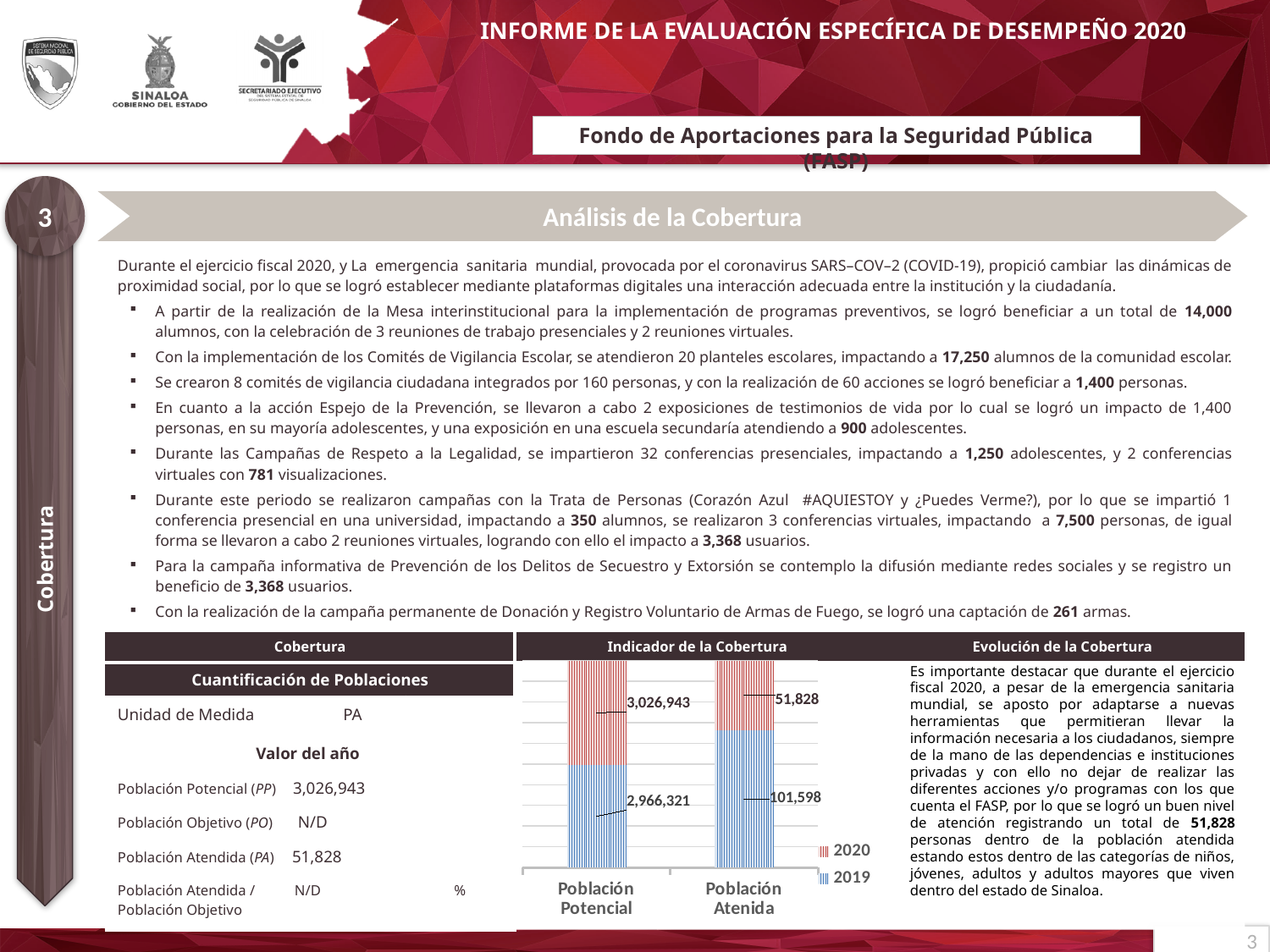
In the chart titled 'Indicador de la Cobertura', what is the difference between the 2019 and 2020 values for Población Atendida? 49,770 In the chart titled 'Indicador de la Cobertura', how many series does the legend list? 2 In the chart titled 'Indicador de la Cobertura', which category and year has the lowest labelled value? Población Atendida, 2020 In the chart titled 'Indicador de la Cobertura', what is the 2019 value for Población Atendida? 101,598 In the chart titled 'Indicador de la Cobertura', what is the difference between the 2020 and 2019 values for Población Potencial? 60,622 What kind of chart is the 'Indicador de la Cobertura' chart? Stacked bar chart In the chart titled 'Indicador de la Cobertura', what is the 2020 value for Población Potencial? 3,026,943 In the chart titled 'Indicador de la Cobertura', what is the 2020 value for Población Atendida? 51,828 In the chart titled 'Indicador de la Cobertura', how many categories are shown on the x axis? 2 In the chart titled 'Indicador de la Cobertura', for Población Atendida, which year has the larger value, 2020 or 2019? 2019 In the chart titled 'Indicador de la Cobertura', which category and year has the highest labelled value? Población Potencial, 2020 In the chart titled 'Indicador de la Cobertura', what is the 2019 value for Población Potencial? 2,966,321